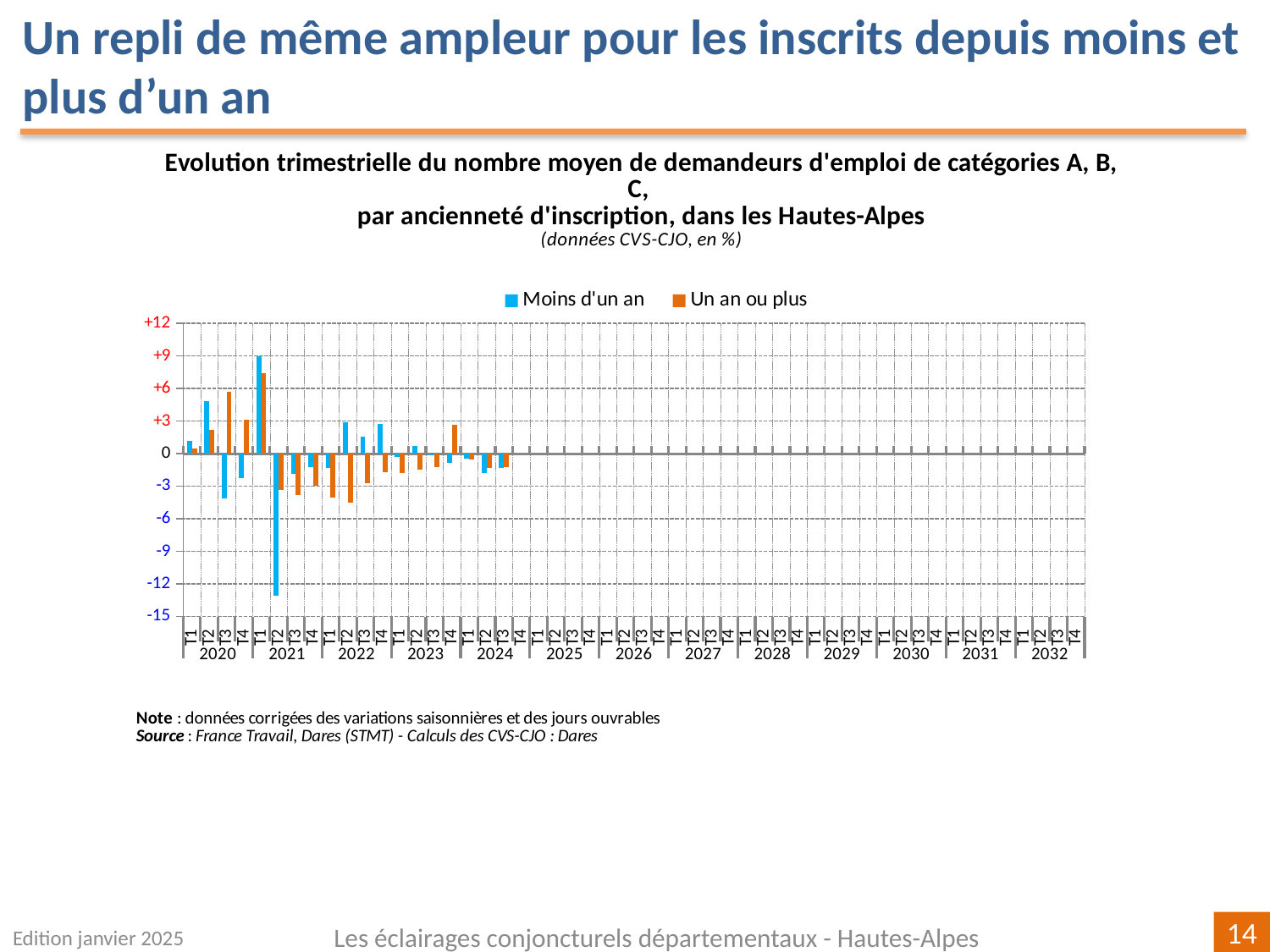
Is the value for 'Moins d'un an' in T2 2020 greater or less than +3? greater How many series does the legend list? 2 Is the value for 'Moins d'un an' in T1 2021 greater or less than +6? greater In T1 2021, which series has the larger value, 'Moins d'un an' or 'Un an ou plus'? Moins d'un an In which quarter does the 'Moins d'un an' series reach its highest value? T1 2021 In which quarter does the 'Moins d'un an' series reach its lowest value? T2 2021 Does the 'Moins d'un an' series rise or fall from T1 2021 to T2 2021? fall Which series is drawn in orange? Un an ou plus Is the value for 'Moins d'un an' in T2 2021 greater or less than -12? less In T3 2020, which series has the larger value, 'Moins d'un an' or 'Un an ou plus'? Un an ou plus What kind of chart is shown on the slide? bar chart